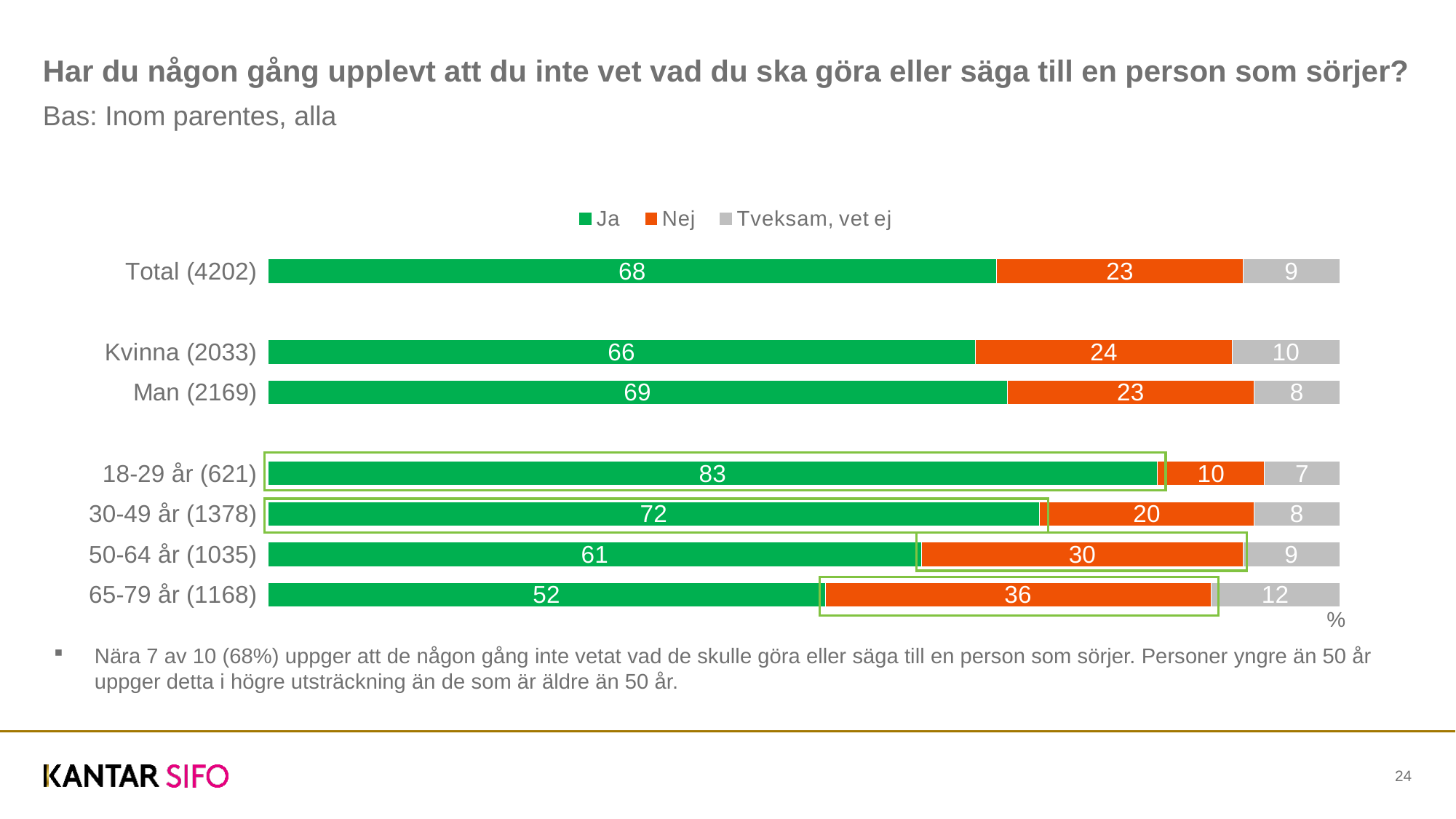
What is the 'Nej' value for 65-79 år (1168)? 36 Which has a larger 'Nej' value, Kvinna (2033) or Man (2169)? Kvinna (2033) What is the difference between the 'Ja' values for 18-29 år (621) and 65-79 år (1168)? 31 What is the 'Tveksam, vet ej' value for Kvinna (2033)? 10 Which category has the highest 'Ja' value? 18-29 år (621) What is the total of the stacked bar for 50-64 år (1035)? 100 Which category has the lowest 'Ja' value? 65-79 år (1168) How many series does the legend list? 3 What is the 'Ja' value for Total (4202)? 68 Which colour represents 'Nej' in the legend? Orange What kind of chart is shown on the slide? Stacked bar chart How many categories are shown on the chart? 7